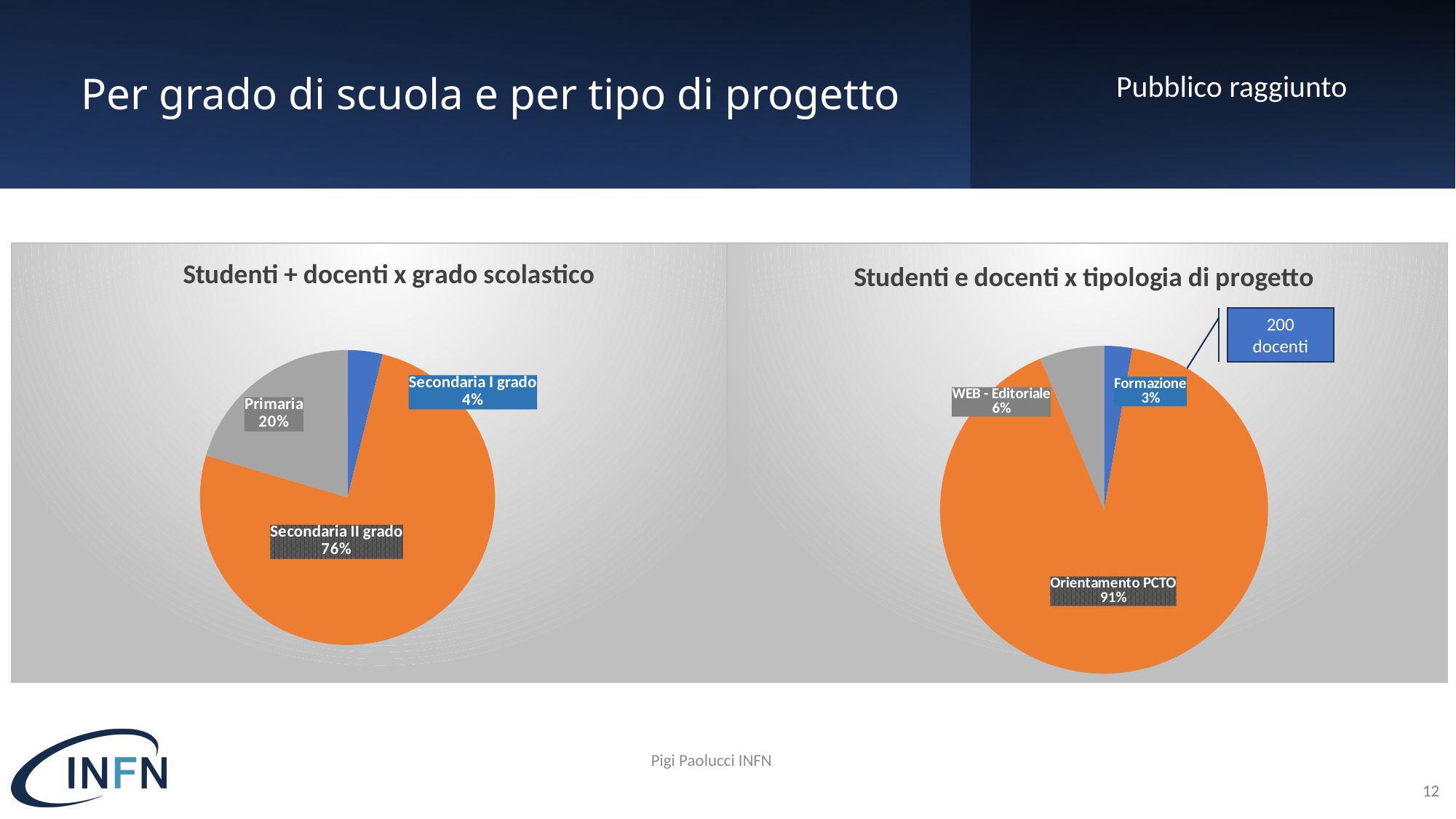
What kind of chart is the chart titled "Studenti e docenti x tipologia di progetto"? Pie chart In the chart titled "Studenti e docenti x tipologia di progetto", which category has the smallest slice? Formazione In the chart titled "Studenti + docenti x grado scolastico", which category has the smallest slice? Secondaria I grado In the chart titled "Studenti + docenti x grado scolastico", what share does Secondaria II grado have? 76% In the chart titled "Studenti e docenti x tipologia di progetto", which is larger, WEB - Editoriale or Formazione? WEB - Editoriale In the chart titled "Studenti + docenti x grado scolastico", which category has the largest slice? Secondaria II grado In the chart titled "Studenti e docenti x tipologia di progetto", what share does Orientamento PCTO have? 91% In the chart titled "Studenti e docenti x tipologia di progetto", what share does WEB - Editoriale have? 6% In the chart titled "Studenti + docenti x grado scolastico", how many categories are shown? 3 In the chart titled "Studenti + docenti x grado scolastico", what is the difference in percentage points between Secondaria II grado and Primaria? 56